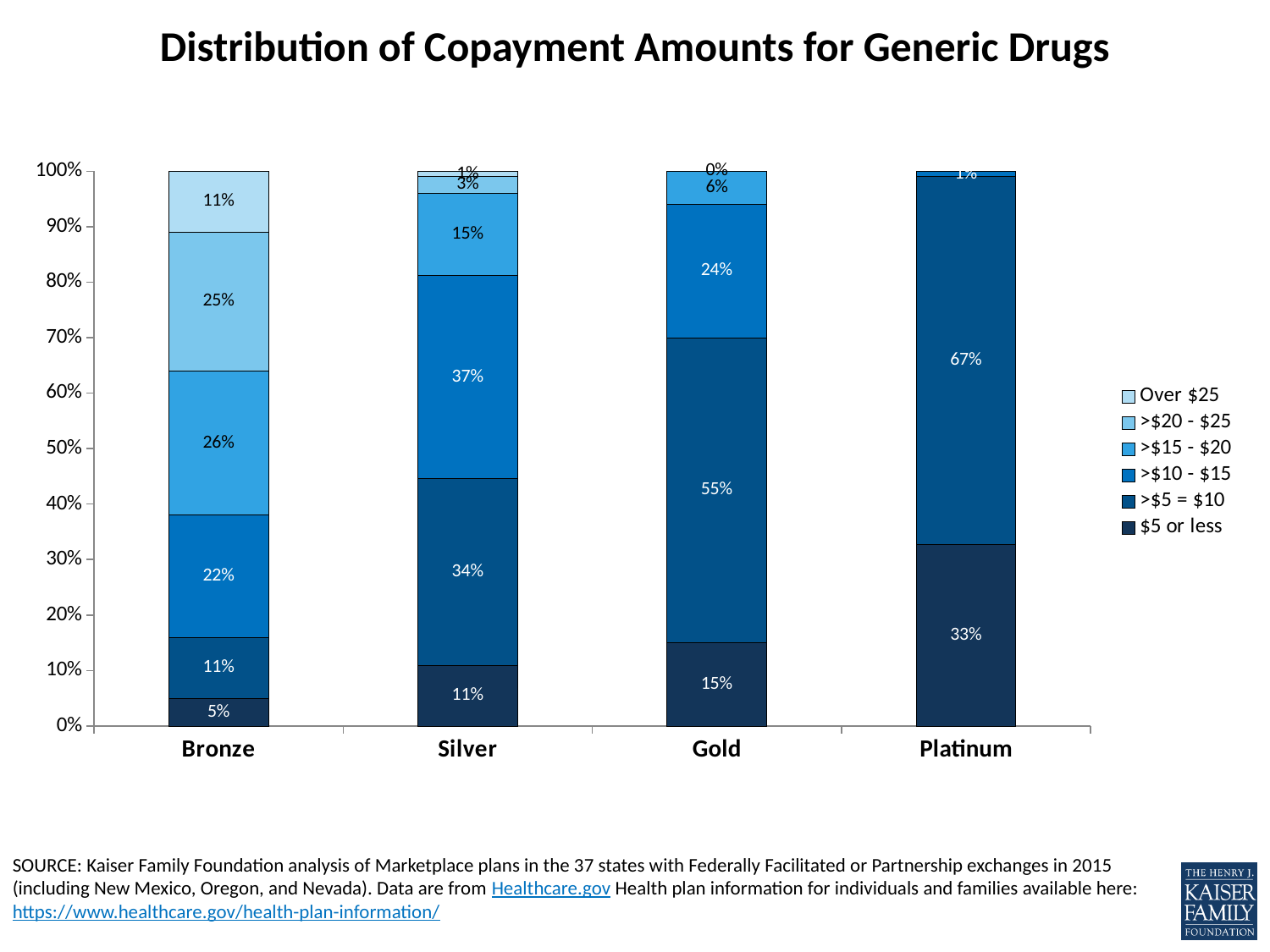
What is the title of the chart? Distribution of Copayment Amounts for Generic Drugs How many copayment ranges does the legend list? 6 Which metal level has the largest share of plans with a generic drug copayment of $5 or less? Platinum What share of Gold plans have a generic drug copayment of >$5 = $10? 55% Which metal level has the smallest share of plans with a generic drug copayment of $5 or less? Bronze Which is larger: the Bronze share for >$15 - $20 or the Silver share for >$15 - $20? Bronze What share of Bronze plans have a generic drug copayment of Over $25? 11% What is the difference between the Platinum and Gold shares for the >$5 = $10 copayment range? 12% What share of Platinum plans have a generic drug copayment of $5 or less? 33% What share of Silver plans have a generic drug copayment of >$10 - $15? 37% What kind of chart is shown on the slide? Stacked bar chart How many metal levels are shown on the x axis? 4